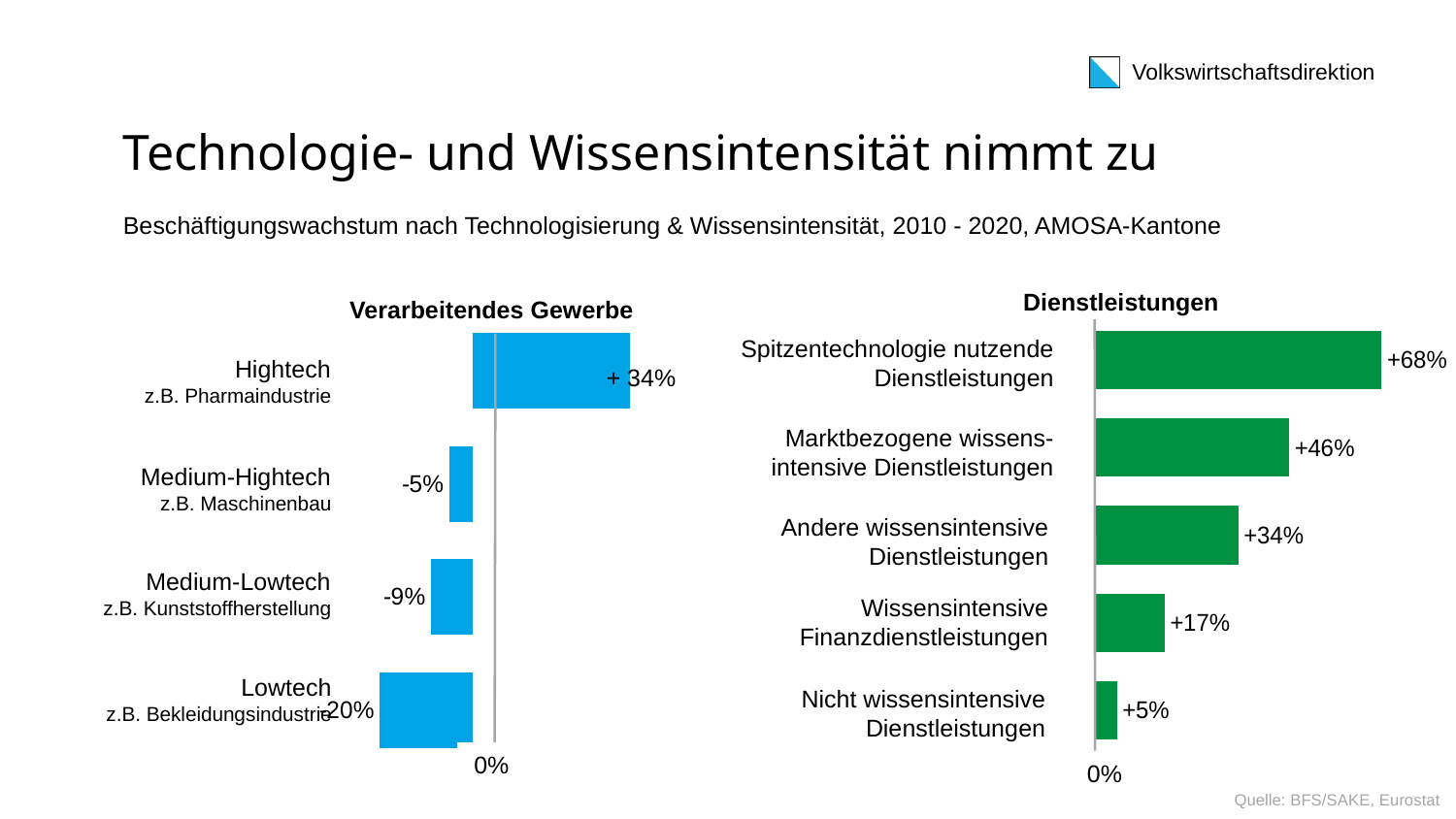
How many categories are shown in the Dienstleistungen chart? 5 In the Verarbeitendes Gewerbe chart, what is the value for Hightech? +34% In the Verarbeitendes Gewerbe chart, what is the value for Medium-Hightech? -5% In the Dienstleistungen chart, what is the value for Nicht wissensintensive Dienstleistungen? +5% In the Dienstleistungen chart, what is the value for Spitzentechnologie nutzende Dienstleistungen? +68% In the Verarbeitendes Gewerbe chart, which category has the lowest value? Lowtech In the Dienstleistungen chart, what is the difference between Spitzentechnologie nutzende Dienstleistungen and Marktbezogene wissensintensive Dienstleistungen? 22 percentage points What kind of chart is the Verarbeitendes Gewerbe chart? bar chart In the Dienstleistungen chart, which category has the highest value? Spitzentechnologie nutzende Dienstleistungen In the Verarbeitendes Gewerbe chart, what is the value for Medium-Lowtech? -9% In the Verarbeitendes Gewerbe chart, is the value for Lowtech greater or less than 0%? less In the Verarbeitendes Gewerbe chart, which is larger, the value for Medium-Hightech or for Medium-Lowtech? Medium-Hightech